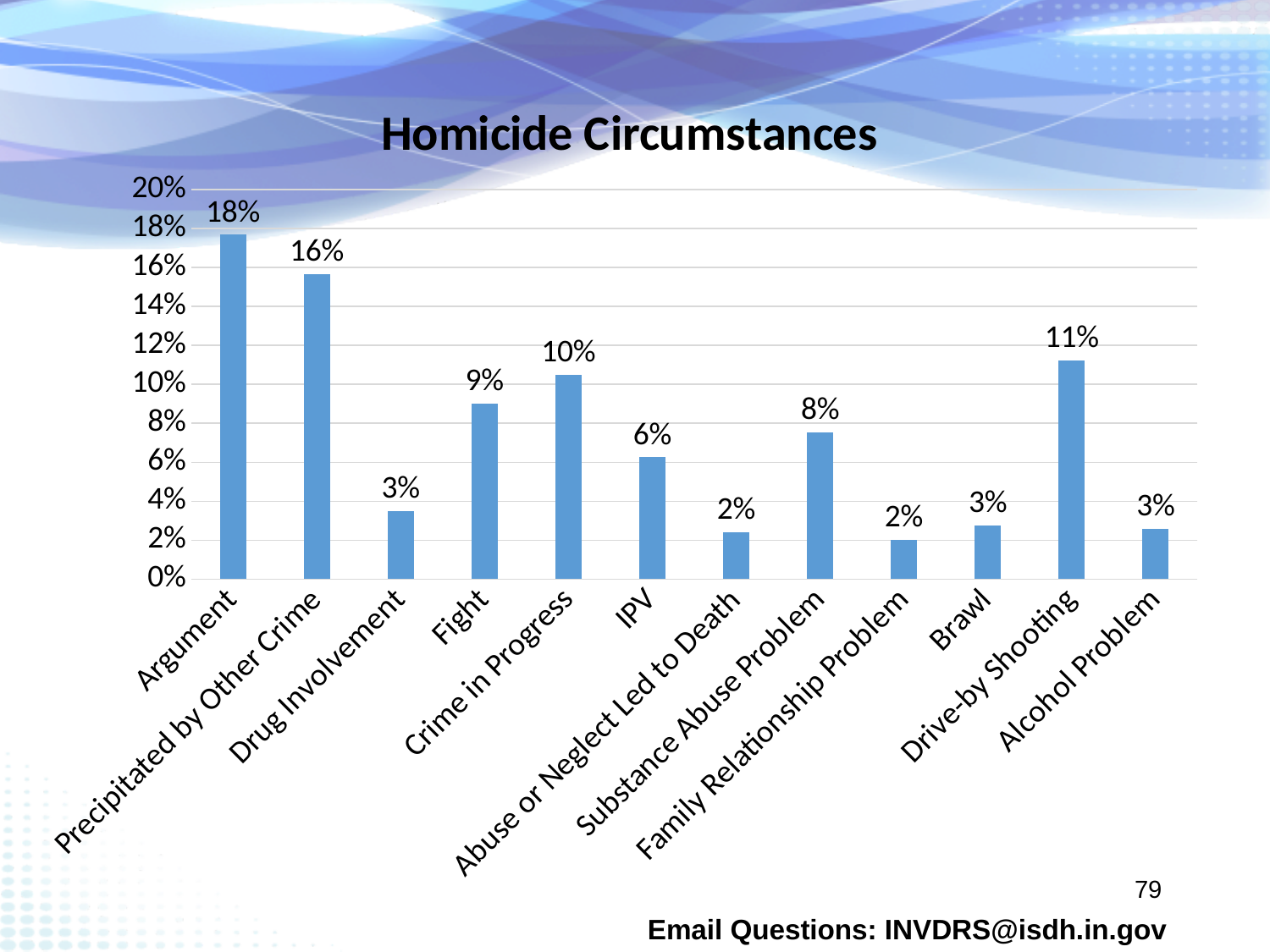
What is the value for Drive-by Shooting? 11% What is the title of the chart? Homicide Circumstances Is the value for Precipitated by Other Crime greater or less than 14%? greater Which is larger, the value for Fight or the value for Crime in Progress? Crime in Progress What is the value for Substance Abuse Problem? 8% How many circumstance categories are shown in the chart? 12 What is the value for Argument? 18% What is the value for IPV? 6% Which circumstance has the highest value? Argument What kind of chart is shown on the slide? Bar chart What is the difference between the values for Argument and Precipitated by Other Crime? 2% What is the difference between the values for Drive-by Shooting and Brawl? 8%